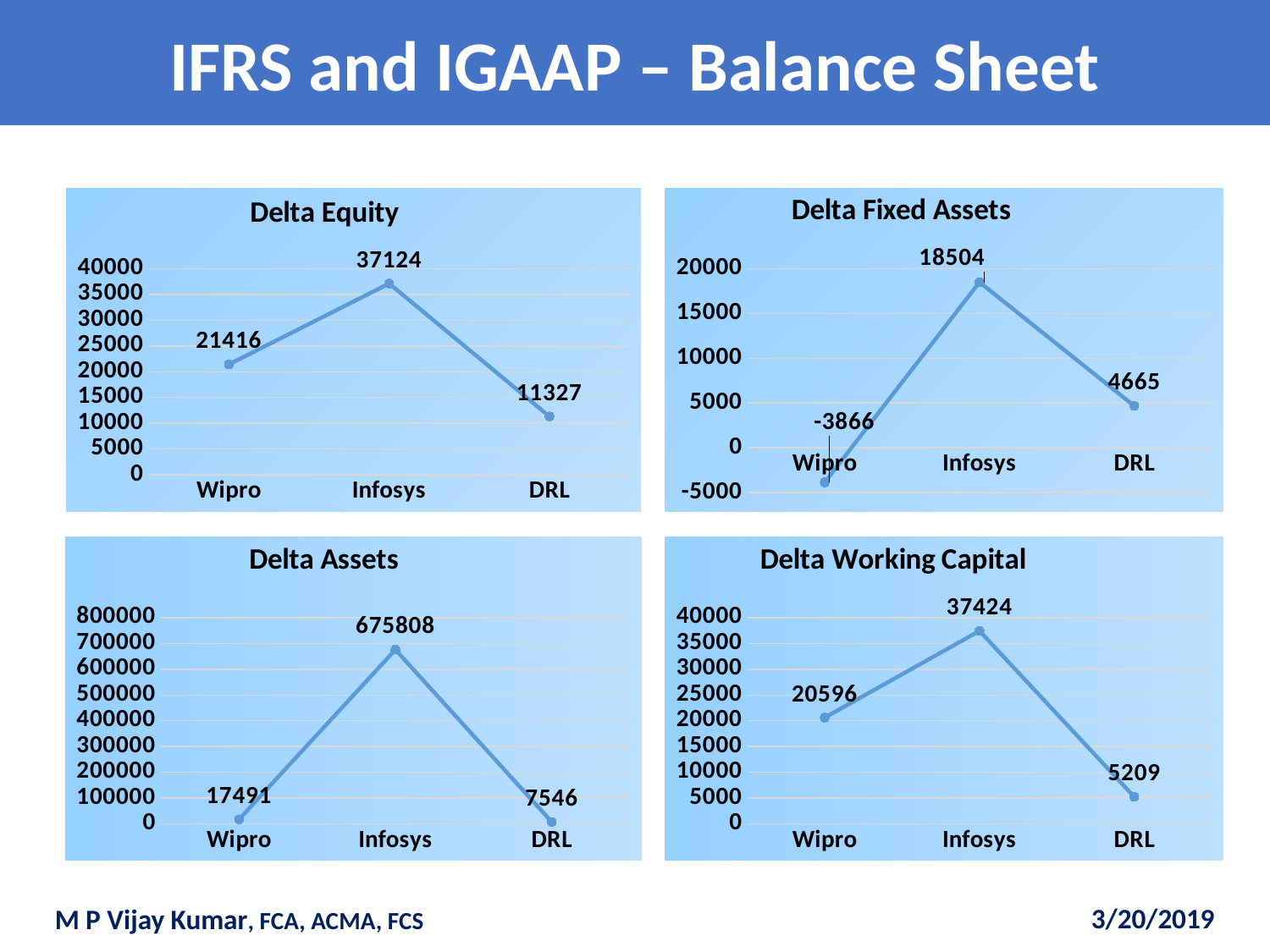
In the Delta Equity chart, which company has the lowest value? DRL In the Delta Assets chart, what is the value for DRL? 7546 In the Delta Assets chart, which company has the highest value? Infosys In the Delta Fixed Assets chart, what is the value for Wipro? -3866 In the Delta Working Capital chart, what is the difference between the values for Infosys and DRL? 32215 In the Delta Equity chart, what is the value for Infosys? 37124 In the Delta Fixed Assets chart, what is the difference between the values for Infosys and DRL? 13839 How many charts are shown on the slide? 4 How many companies are plotted in the Delta Assets chart? 3 In the Delta Equity chart, which is larger, the value for Wipro or the value for DRL? Wipro In the Delta Working Capital chart, what is the value for Wipro? 20596 What kind of chart is the Delta Working Capital chart? Line chart